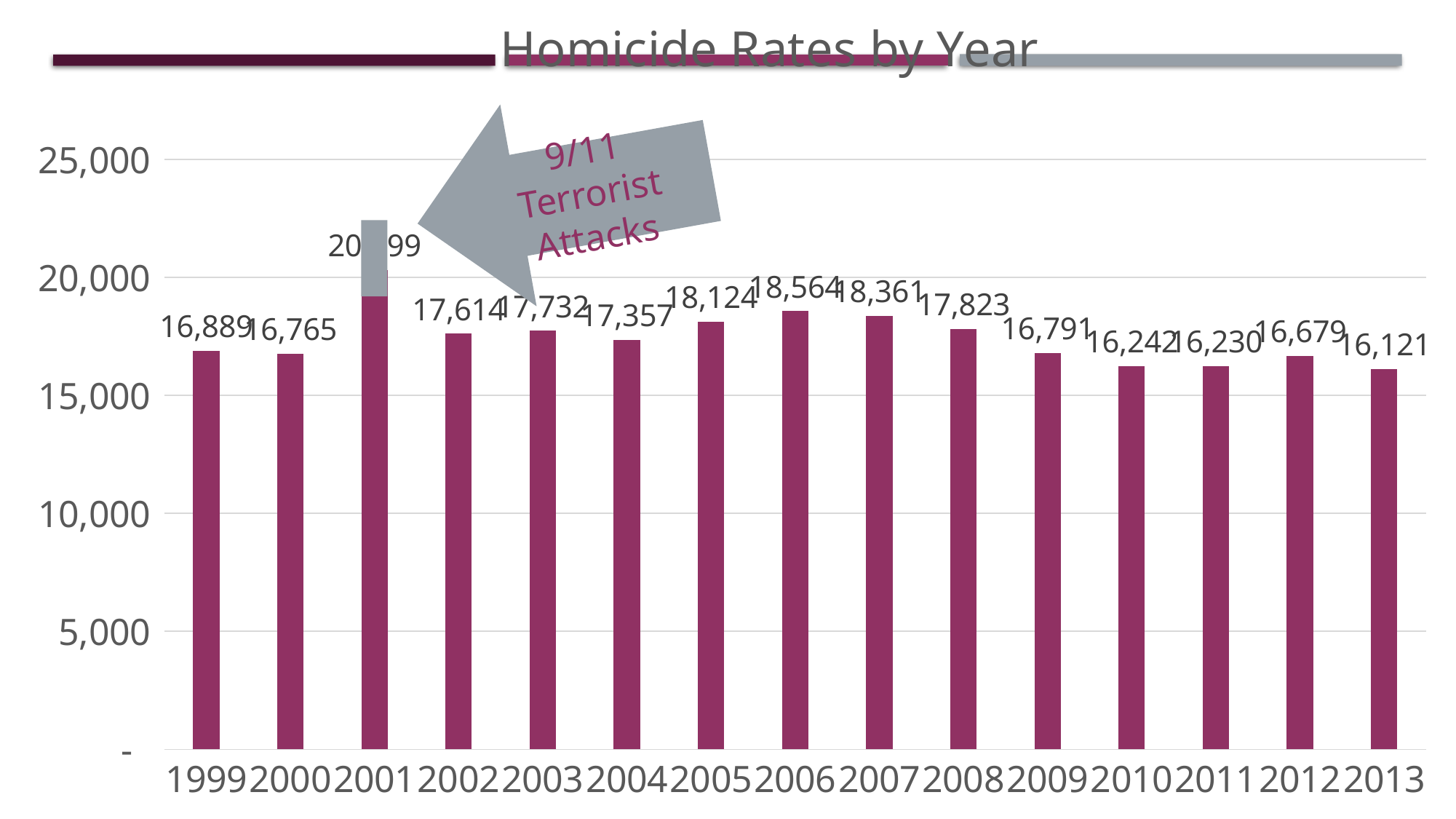
Which year has the highest bar in the chart? 2001 What is the homicide value shown for 2006? 18,564 Which year has the lowest value in the chart? 2013 What is the homicide value shown for 2013? 16,121 What is the homicide value shown for 1999? 16,889 What kind of chart is shown on the slide? bar chart Which year has the larger value, 2008 or 2009? 2008 What is the title of the chart? Homicide Rates by Year What is the difference between the values for 2006 and 2005? 440 What is the homicide value shown for 2010? 16,242 Is the value for 2001 greater or less than 20,000? greater How many years are shown on the x axis of the chart? 15